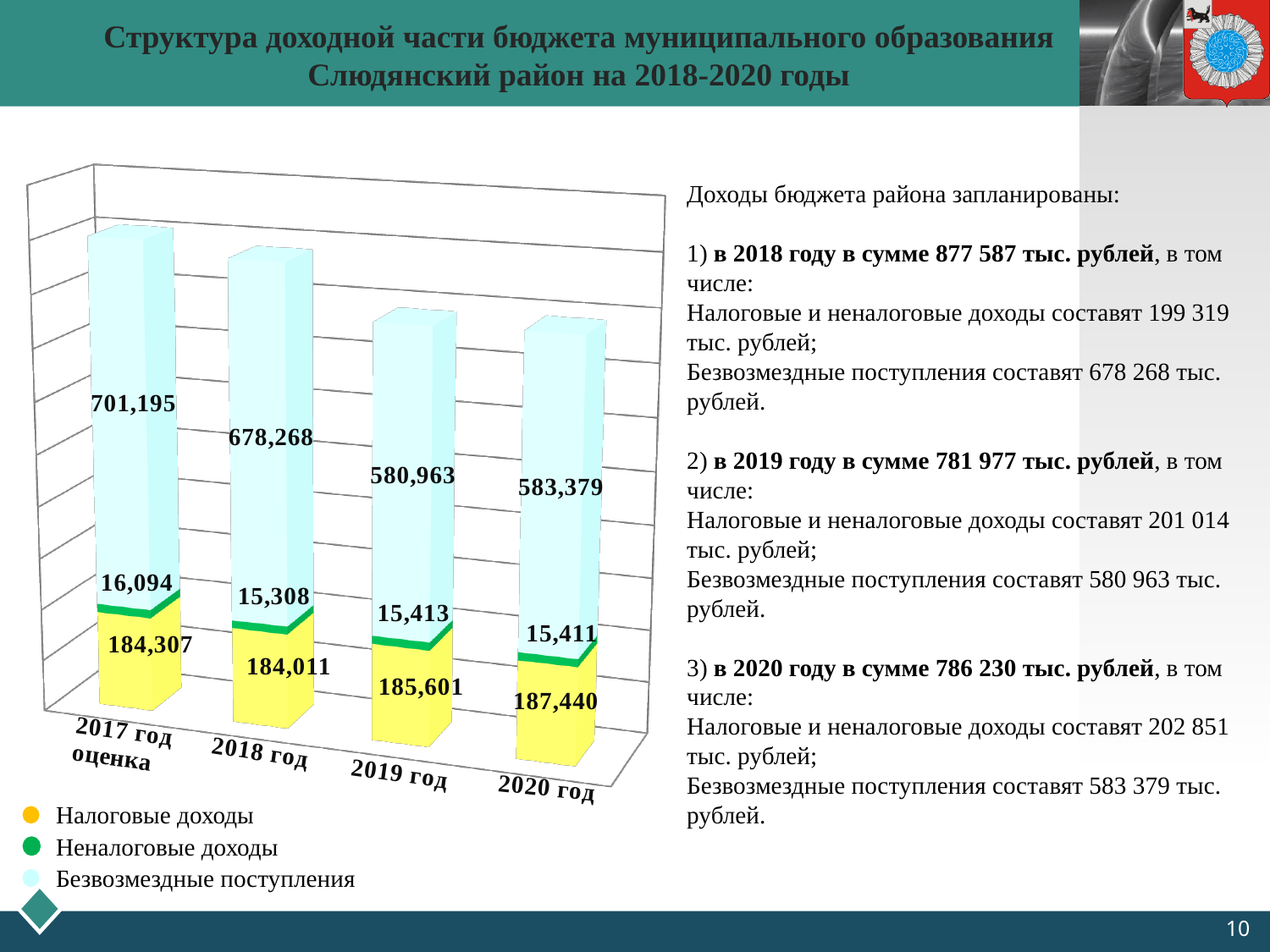
How many series does the legend list? 3 Does the value of Безвозмездные поступления rise or fall from 2017 год оценка to 2019 год? Fall How many years (categories) are shown on the x axis? 4 What is the value of Налоговые доходы for 2020 год? 187,440 What is the value of Безвозмездные поступления for 2017 год оценка? 701,195 What is the total of the stacked bar for 2018 год? 877,587 What kind of chart is shown on the slide? Stacked bar chart What is the value of Неналоговые доходы for 2019 год? 15,413 What is the difference between Безвозмездные поступления in 2018 год and 2019 год? 97,305 Which year has the highest value of Безвозмездные поступления? 2017 год оценка Which year has the lowest value of Неналоговые доходы? 2018 год Which is larger: Налоговые доходы in 2019 год or in 2020 год? 2020 год